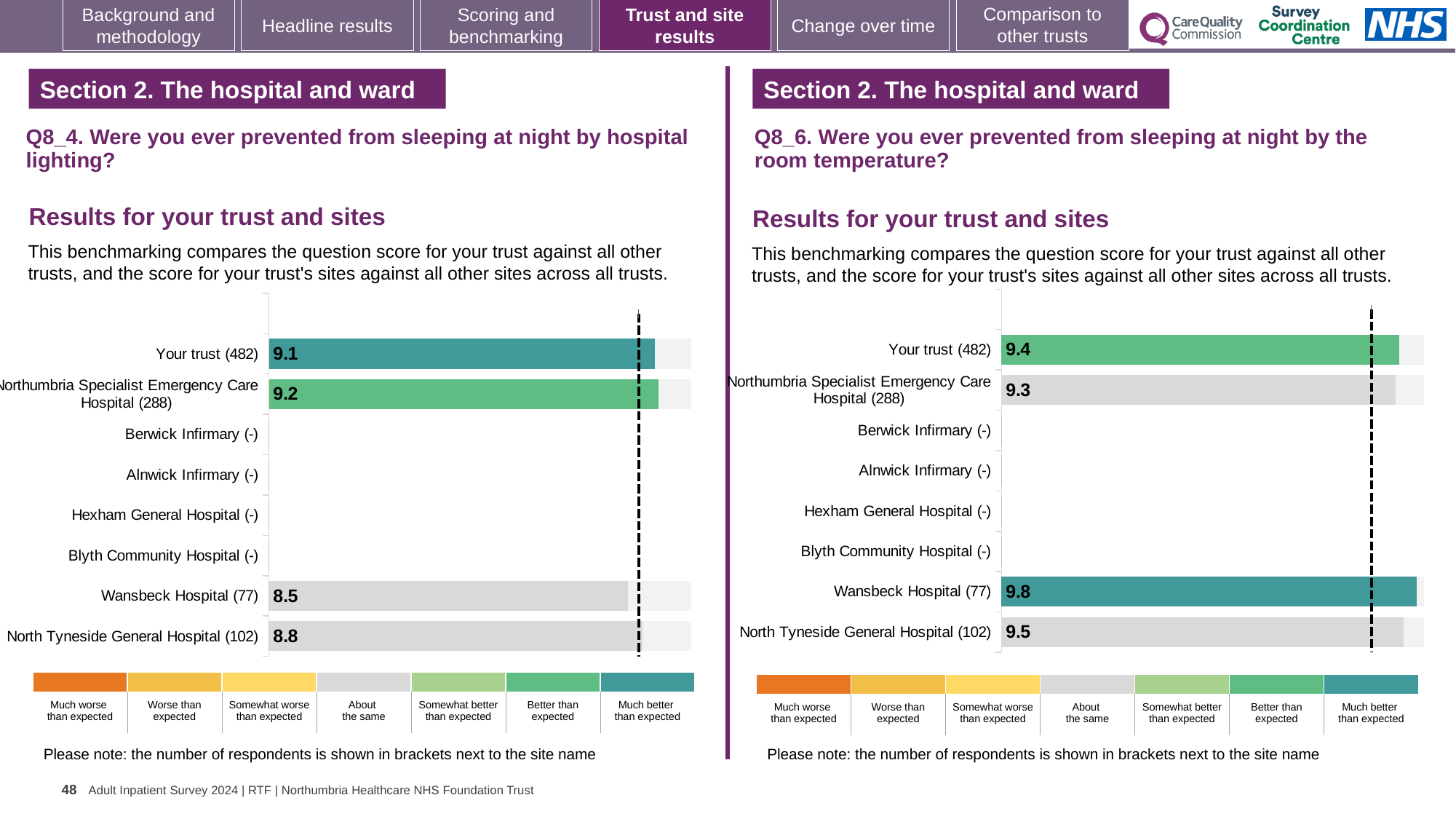
In the Q8_4 hospital lighting chart, what is the score for Wansbeck Hospital (77)? 8.5 In the Q8_6 room temperature chart, what is the score for Wansbeck Hospital (77)? 9.8 What kind of chart is used in the Q8_4 hospital lighting chart? Bar chart In the Q8_4 hospital lighting chart, what is the difference between the scores for Northumbria Specialist Emergency Care Hospital (288) and North Tyneside General Hospital (102)? 0.4 In the Q8_6 room temperature chart, which is larger: the score for Your trust (482) or Northumbria Specialist Emergency Care Hospital (288)? Your trust (482) In the Q8_4 hospital lighting chart, which site has the lowest score? Wansbeck Hospital (77) In the Q8_6 room temperature chart, what colour category does the Wansbeck Hospital (77) bar fall into according to the legend? Much better than expected In the Q8_6 room temperature chart, which site has the highest score? Wansbeck Hospital (77) In the Q8_6 room temperature chart, what is the score for North Tyneside General Hospital (102)? 9.5 In the Q8_6 room temperature chart, what is the difference between the scores for Wansbeck Hospital (77) and Your trust (482)? 0.4 In the Q8_4 hospital lighting chart, what is the score for Your trust (482)? 9.1 In the Q8_4 hospital lighting chart, how many sites have a score shown as a bar? 4